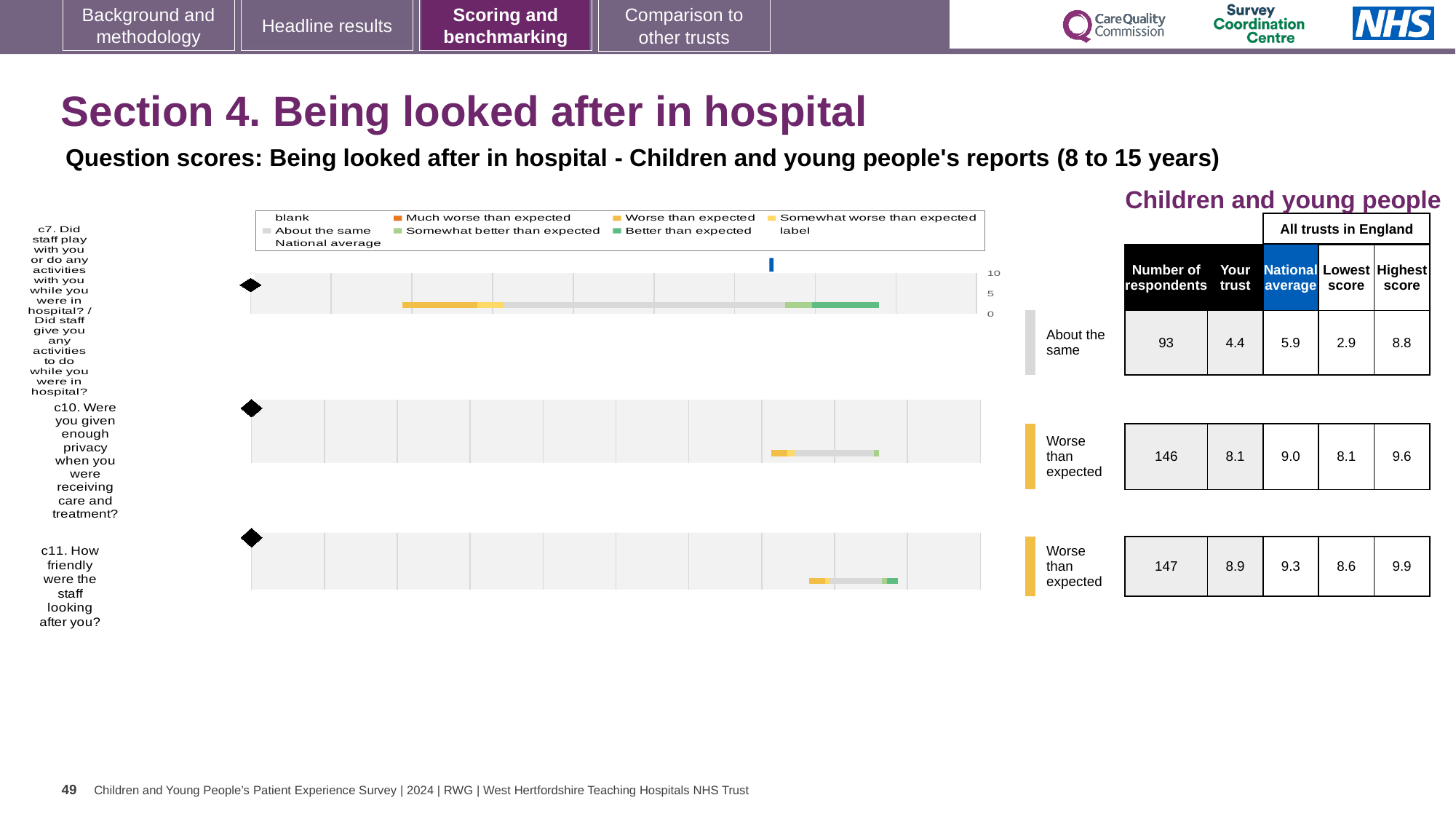
How many questions are charted on this slide? 3 What benchmark rating is given to question c10 (Were you given enough privacy when you were receiving care and treatment?)? Worse than expected What is the lowest score across all trusts in England for question c10? 8.1 Which question has the lowest 'Your trust' score? c7. Did staff play with you or do any activities with you while you were in hospital? What is the 'Your trust' score for question c10 (Were you given enough privacy when you were receiving care and treatment?)? 8.1 Which question has the largest number of respondents? c11. How friendly were the staff looking after you? For question c7, what is the difference between the national average and the 'Your trust' score? 1.5 For question c11, which is larger: the 'Your trust' score or the national average? National average How many respondents are shown for question c7 (Did staff play with you or do any activities with you while you were in hospital?)? 93 What is the highest score across all trusts in England for question c7? 8.8 What kind of chart is used to show the question scores on this slide? Bar chart What is the national average score for question c11 (How friendly were the staff looking after you?)? 9.3